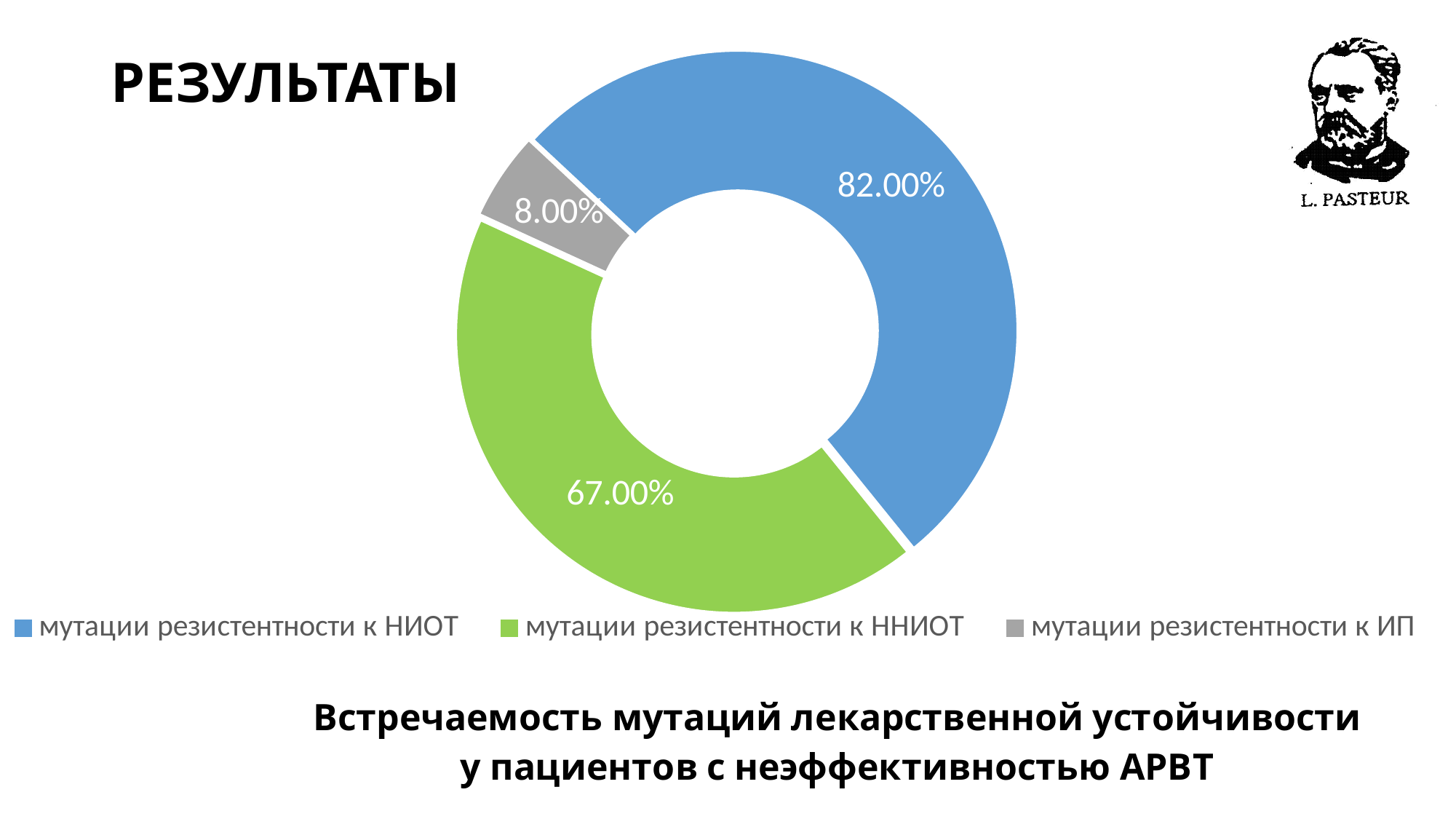
What kind of chart is shown on the slide? doughnut chart How many categories does the chart show? 3 Which category has the highest value? мутации резистентности к НИОТ What is the difference between the values for мутации резистентности к НИОТ and мутации резистентности к ННИОТ? 15.00% What value is shown for мутации резистентности к ИП? 8.00% Which category has the lowest value? мутации резистентности к ИП Which is larger: the value for мутации резистентности к ННИОТ or for мутации резистентности к ИП? мутации резистентности к ННИОТ What is the caption below the chart? Встречаемость мутаций лекарственной устойчивости у пациентов с неэффективностью АРВТ What value is shown for мутации резистентности к НИОТ? 82.00% What colour is the slice for мутации резистентности к ИП? grey What value is shown for мутации резистентности к ННИОТ? 67.00% What is the difference between the values for мутации резистентности к ННИОТ and мутации резистентности к ИП? 59.00%